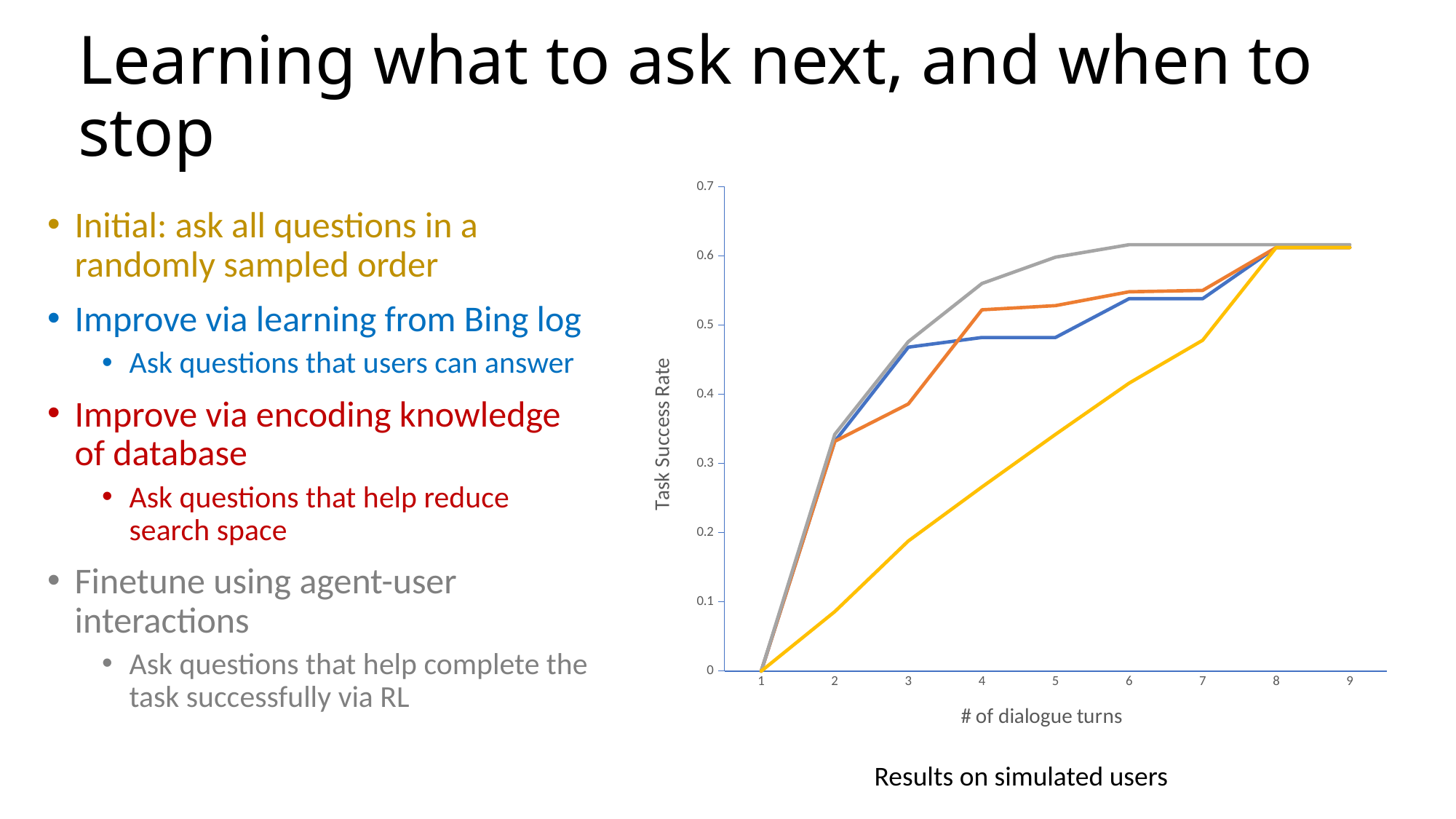
What is the title of the x axis of the chart? # of dialogue turns What kind of chart is shown on the slide? line chart What is the title of the y axis of the chart? Task Success Rate Do the lines in the chart generally rise or fall as the number of dialogue turns increases? rise How many lines are plotted in the chart? 4 At 3 dialogue turns, which line is higher, the blue line or the orange line? the blue line Is the Task Success Rate of the yellow line at 4 dialogue turns greater or less than 0.3? less Which line has the highest Task Success Rate at 4 dialogue turns? the gray line How many dialogue-turn values are marked along the x axis of the chart? 9 Which line has the lowest Task Success Rate at 5 dialogue turns? the yellow line What is the Task Success Rate of all lines at 1 dialogue turn? 0 Is the Task Success Rate of the gray line at 6 dialogue turns greater or less than 0.6? greater